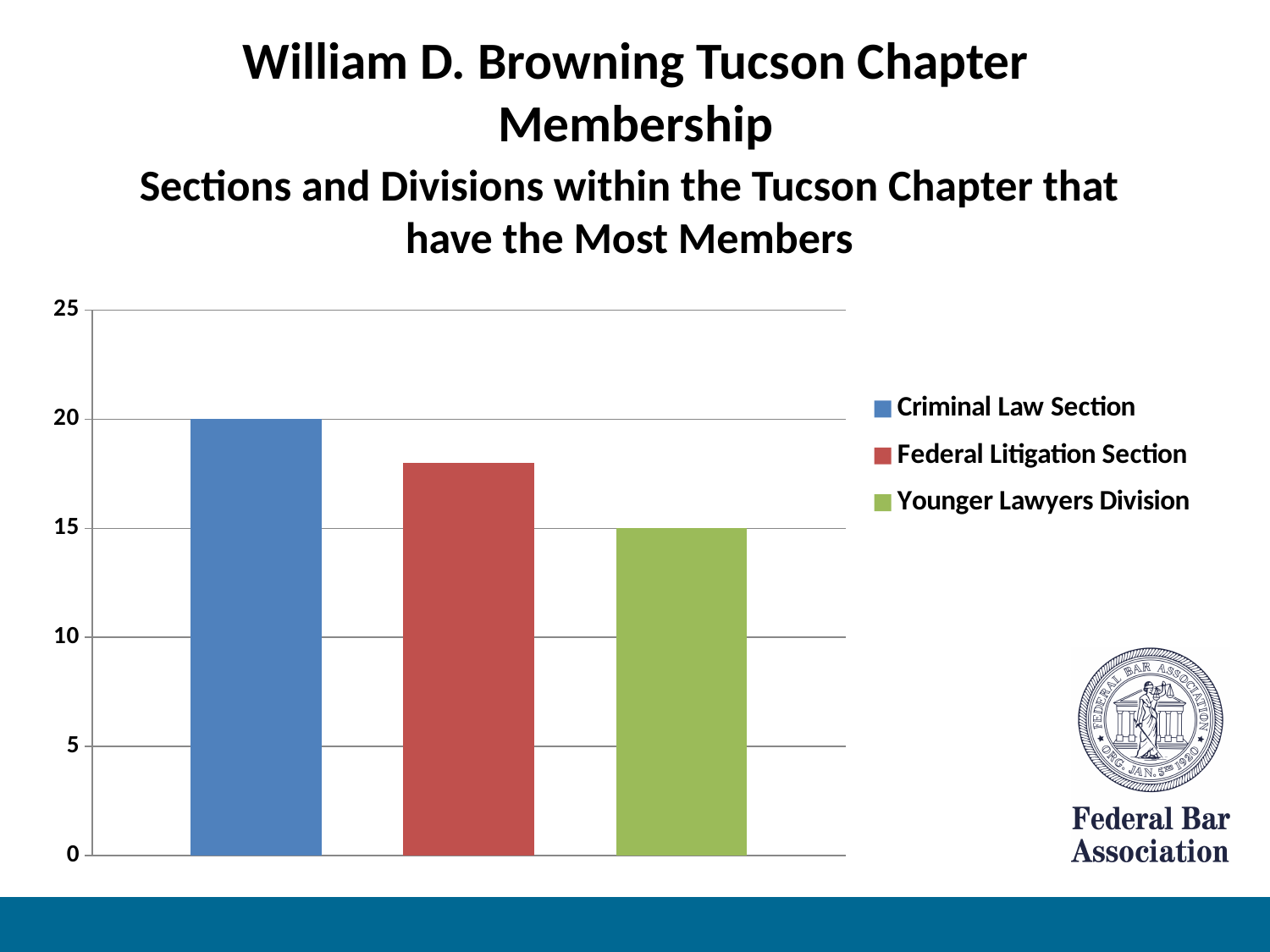
Is the value for the Federal Litigation Section greater or less than 15? greater What is the value for the Younger Lawyers Division? 15 Which section or division has the lowest value? Younger Lawyers Division Which is larger, the value for the Criminal Law Section or the Federal Litigation Section? Criminal Law Section How many series does the legend list? 3 Is the value for the Federal Litigation Section greater or less than 20? less Do the bar values rise or fall from left to right across the chart? Fall Which section or division has the highest value? Criminal Law Section How many bars are plotted in the chart? 3 What is the value for the Criminal Law Section? 20 What is the difference between the values for the Criminal Law Section and the Younger Lawyers Division? 5 What type of chart is shown on the slide? Bar chart